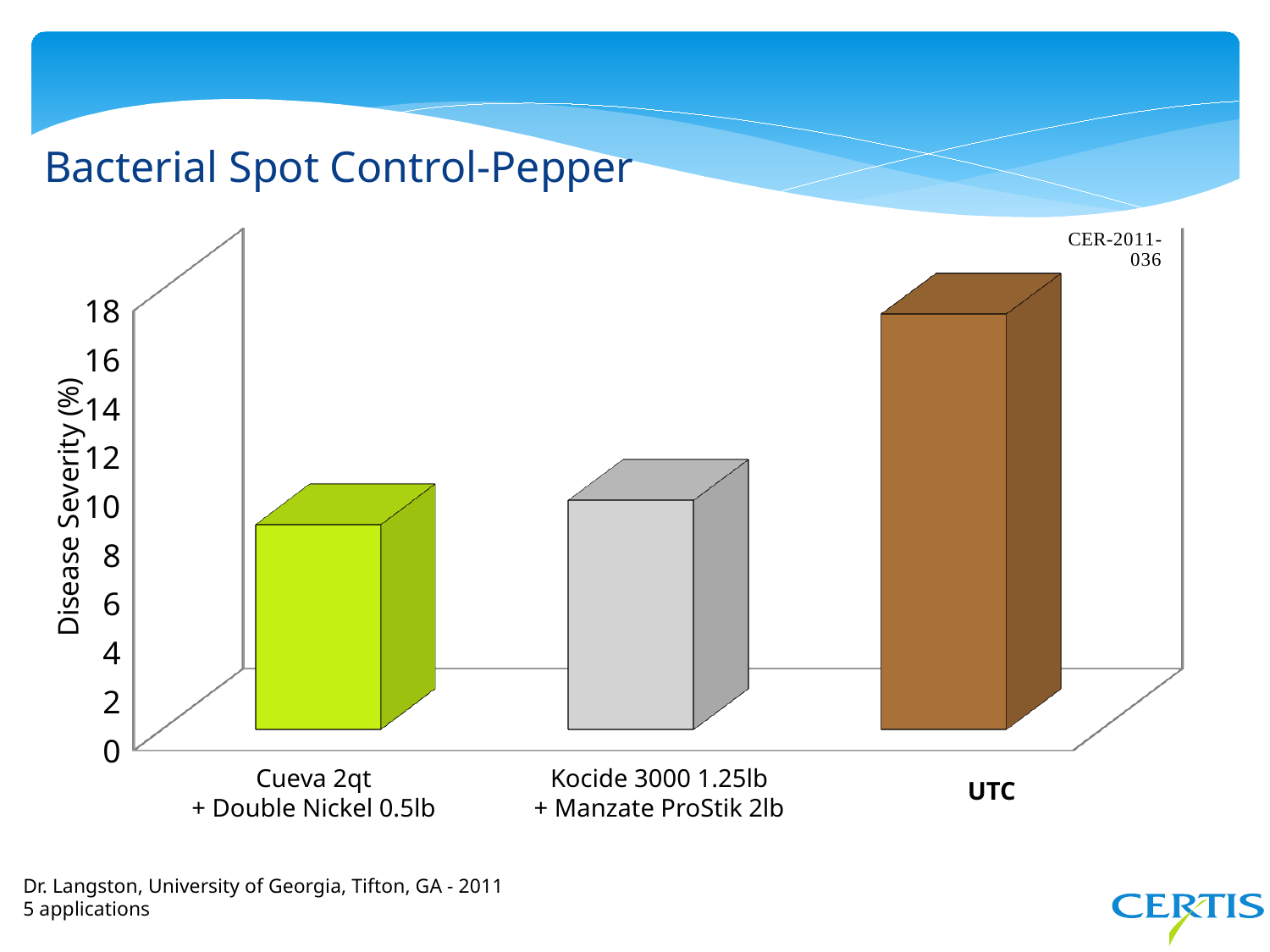
Is the disease severity for UTC greater or less than 14? greater Which category has the highest disease severity? UTC Which has a lower disease severity, Cueva 2qt + Double Nickel 0.5lb or UTC? Cueva 2qt + Double Nickel 0.5lb Which has a higher disease severity, UTC or Kocide 3000 1.25lb + Manzate ProStik 2lb? UTC Is the disease severity for UTC greater or less than 10? greater Which category has the lowest disease severity? Cueva 2qt + Double Nickel 0.5lb Is the disease severity for Cueva 2qt + Double Nickel 0.5lb greater or less than 12? less What is the label on the vertical axis of the chart? Disease Severity (%) What is the title of the chart? Bacterial Spot Control-Pepper How many treatment categories are plotted on the chart? 3 What kind of chart is shown on the slide? bar chart